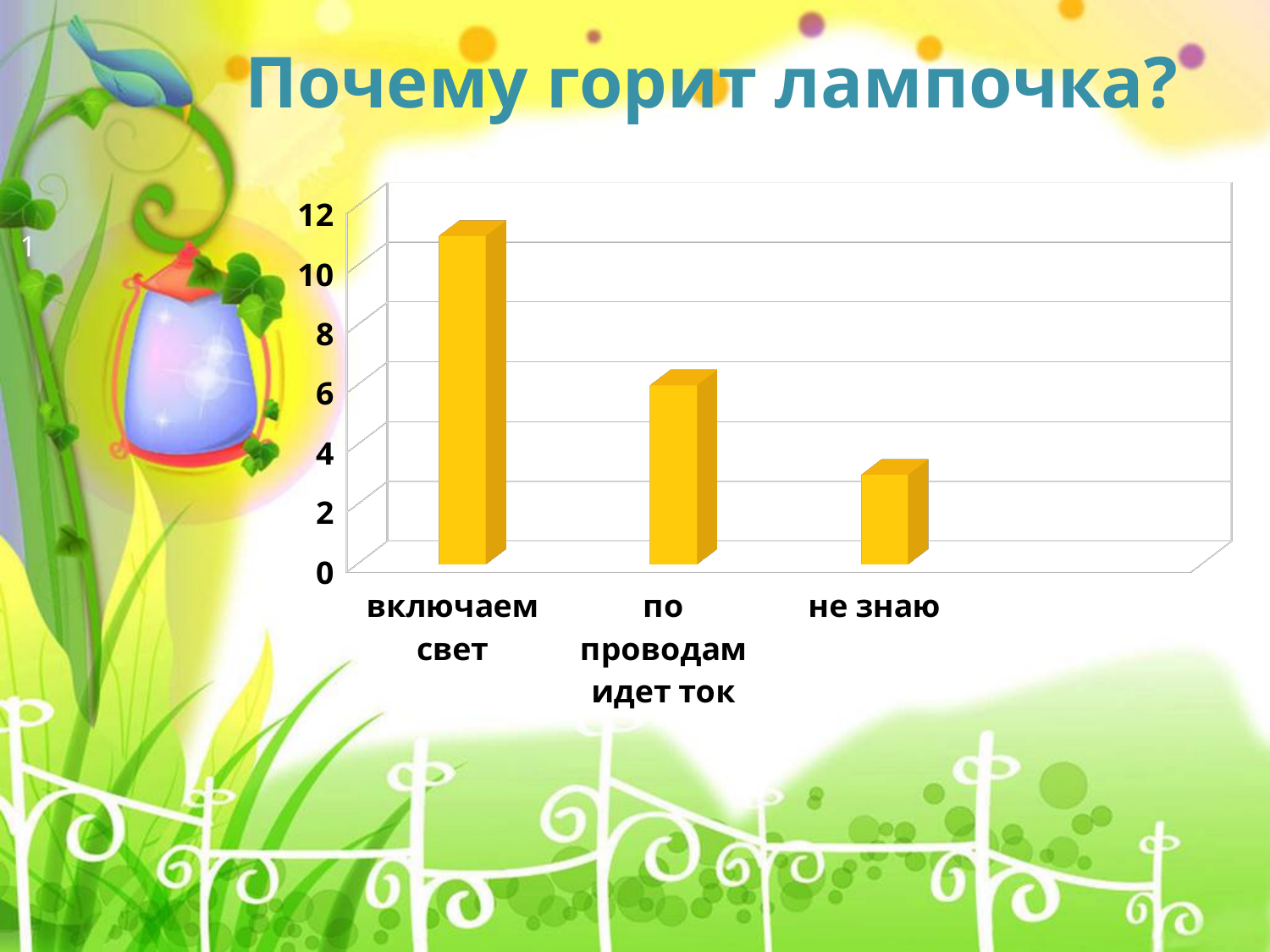
Is the value for "включаем свет" greater or less than 10? greater What colour are the bars in the chart? yellow Which is larger, the value for "по проводам идет ток" or the value for "не знаю"? по проводам идет ток How many categories are shown on the x axis of the chart? 3 Is the value for "не знаю" greater or less than 4? less Which is larger, the value for "включаем свет" or the value for "по проводам идет ток"? включаем свет Do the bar values rise or fall from left to right along the x axis? fall What kind of chart is shown on the slide? bar chart What is the title of the chart on the slide? Почему горит лампочка? Is the value for "по проводам идет ток" greater or less than 8? less Which category has the highest bar? включаем свет Which category has the lowest bar? не знаю